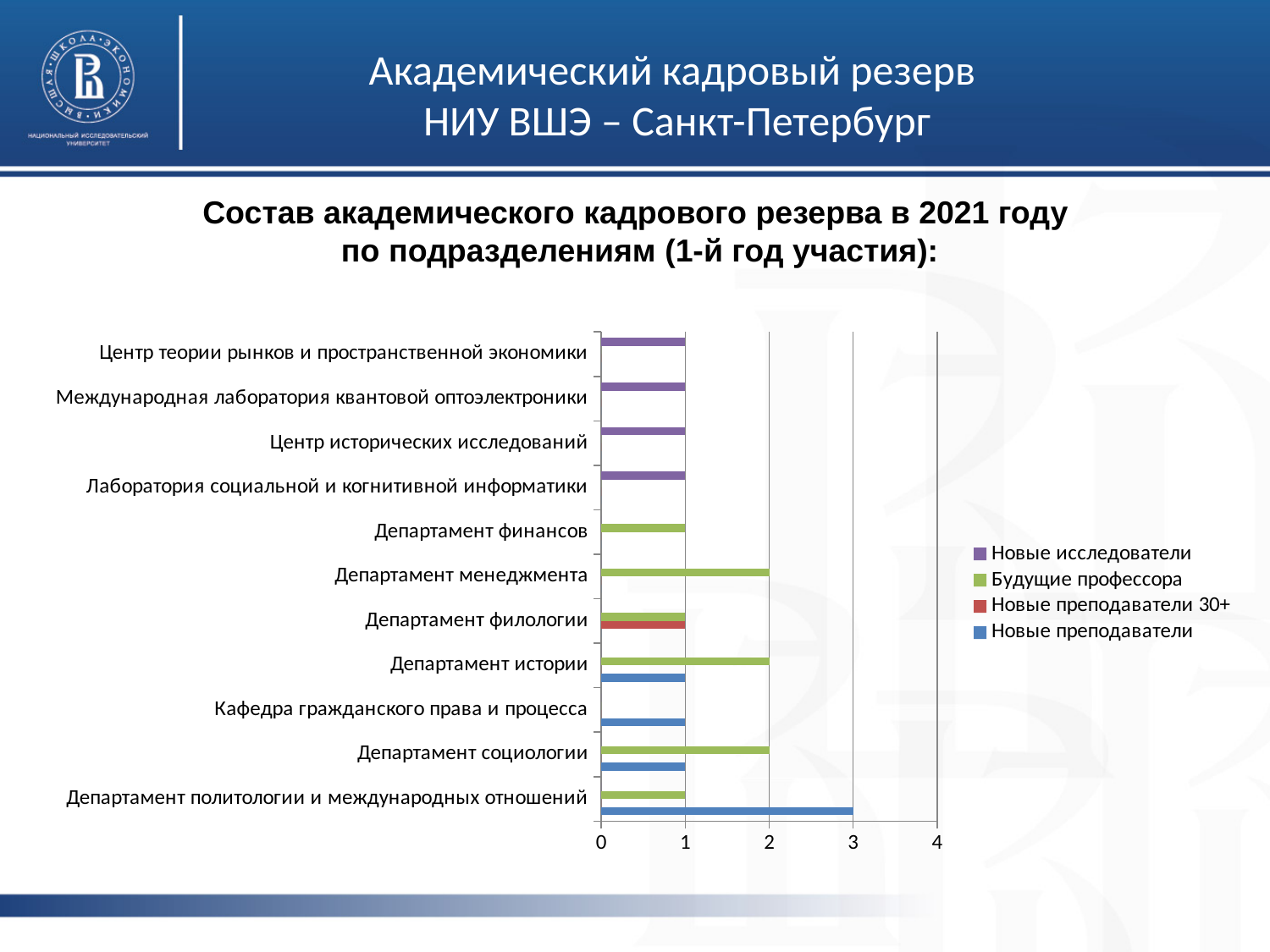
What type of chart is shown on the slide? Bar chart How many departments/units are listed on the vertical axis of the chart? 11 How many series does the legend list? 4 What is the value of 'Новые преподаватели' for 'Департамент политологии и международных отношений'? 3 Is the value of 'Новые преподаватели' for 'Департамент политологии и международных отношений' greater or less than 2? greater What is the value of 'Новые преподаватели 30+' for 'Департамент филологии'? 1 Which is larger: 'Будущие профессора' for 'Департамент социологии' or for 'Департамент финансов'? Департамент социологии What is the value of 'Новые исследователи' for 'Центр исторических исследований'? 1 Which unit has the highest value for 'Новые преподаватели'? Департамент политологии и международных отношений Which series is shown in purple in the legend? Новые исследователи What is the difference between the 'Новые преподаватели' values for 'Департамент политологии и международных отношений' and 'Департамент истории'? 2 What is the value of 'Будущие профессора' for 'Департамент менеджмента'? 2